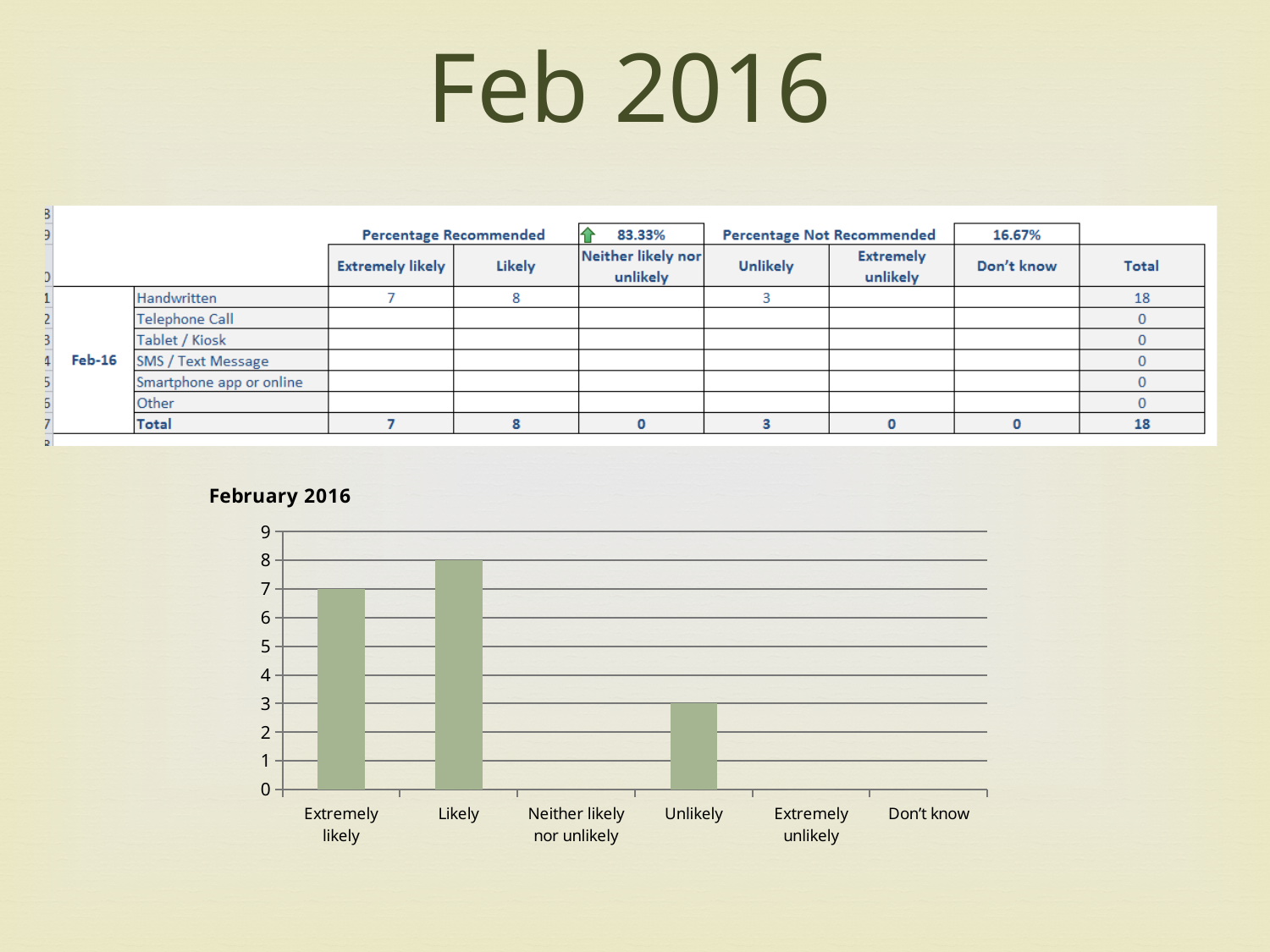
How many categories are shown on the x axis of the chart? 6 What is the value for Unlikely in the chart? 3 What is the value for Don't know in the chart? 0 What kind of chart is shown on the slide? bar chart Which is larger, the value for Extremely likely or the value for Unlikely? Extremely likely What is the value for Extremely likely in the chart? 7 What is the title of the chart? February 2016 What is the difference between the values for Likely and Unlikely? 5 What is the highest value shown on the y axis of the chart? 9 Is the value for Unlikely greater or less than 5? less What is the value for Likely in the chart? 8 Which category has the highest value in the chart? Likely